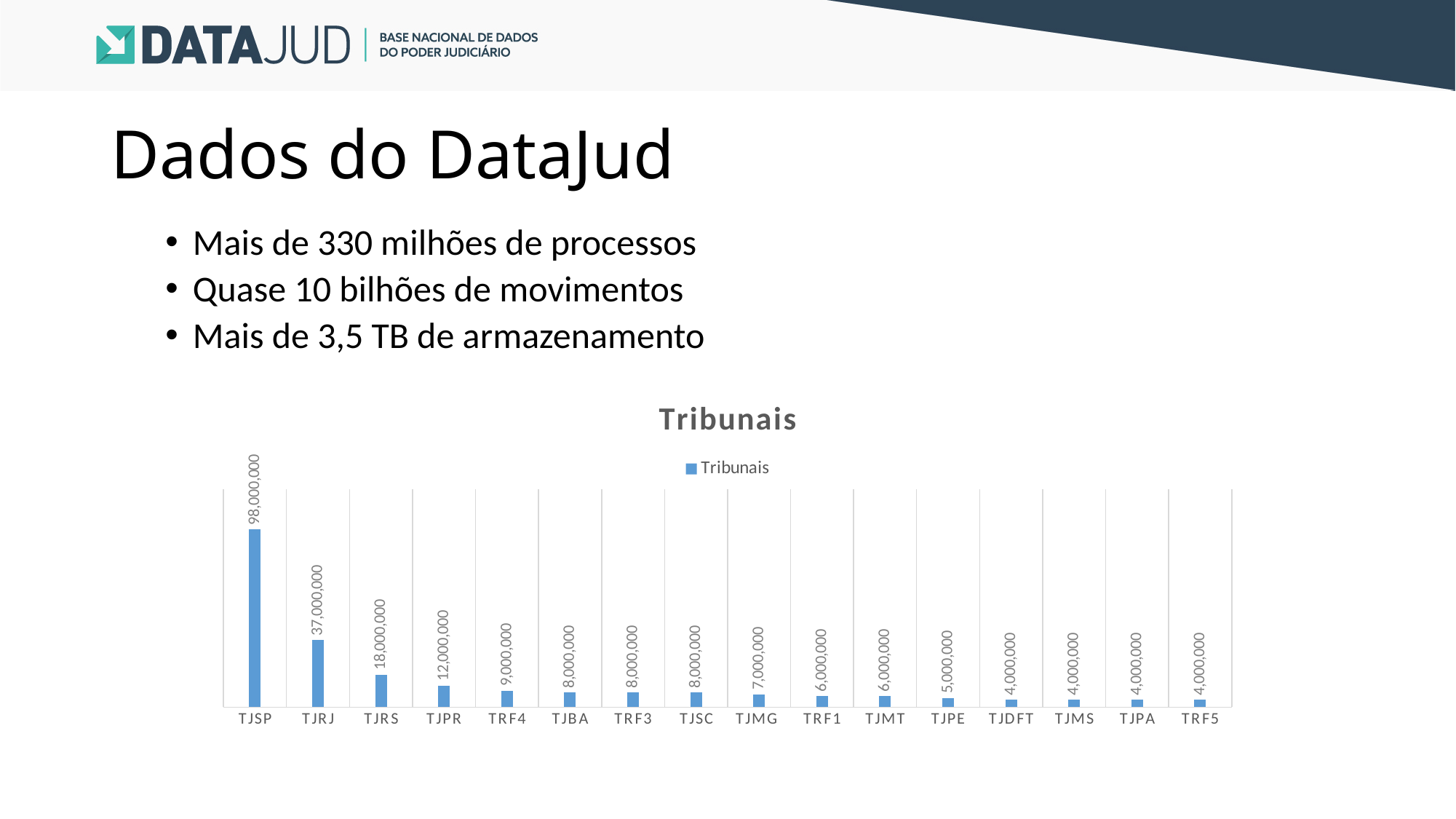
What is the value for TJRJ in the Tribunais chart? 37,000,000 How many tribunals are shown on the x axis of the Tribunais chart? 16 What is the value for TJPE in the Tribunais chart? 5,000,000 What is the value for TRF4 in the Tribunais chart? 9,000,000 What kind of chart is shown on the slide? Bar chart Which is larger, the value for TJRS or the value for TJMG? TJRS What is the difference between the values for TJSP and TJRJ? 61,000,000 What is the title of the chart on the slide? Tribunais What is the value for TJSP in the Tribunais chart? 98,000,000 How many series does the legend of the Tribunais chart list? 1 What is the difference between the values for TJRS and TJPR? 6,000,000 Which tribunal has the highest value in the Tribunais chart? TJSP